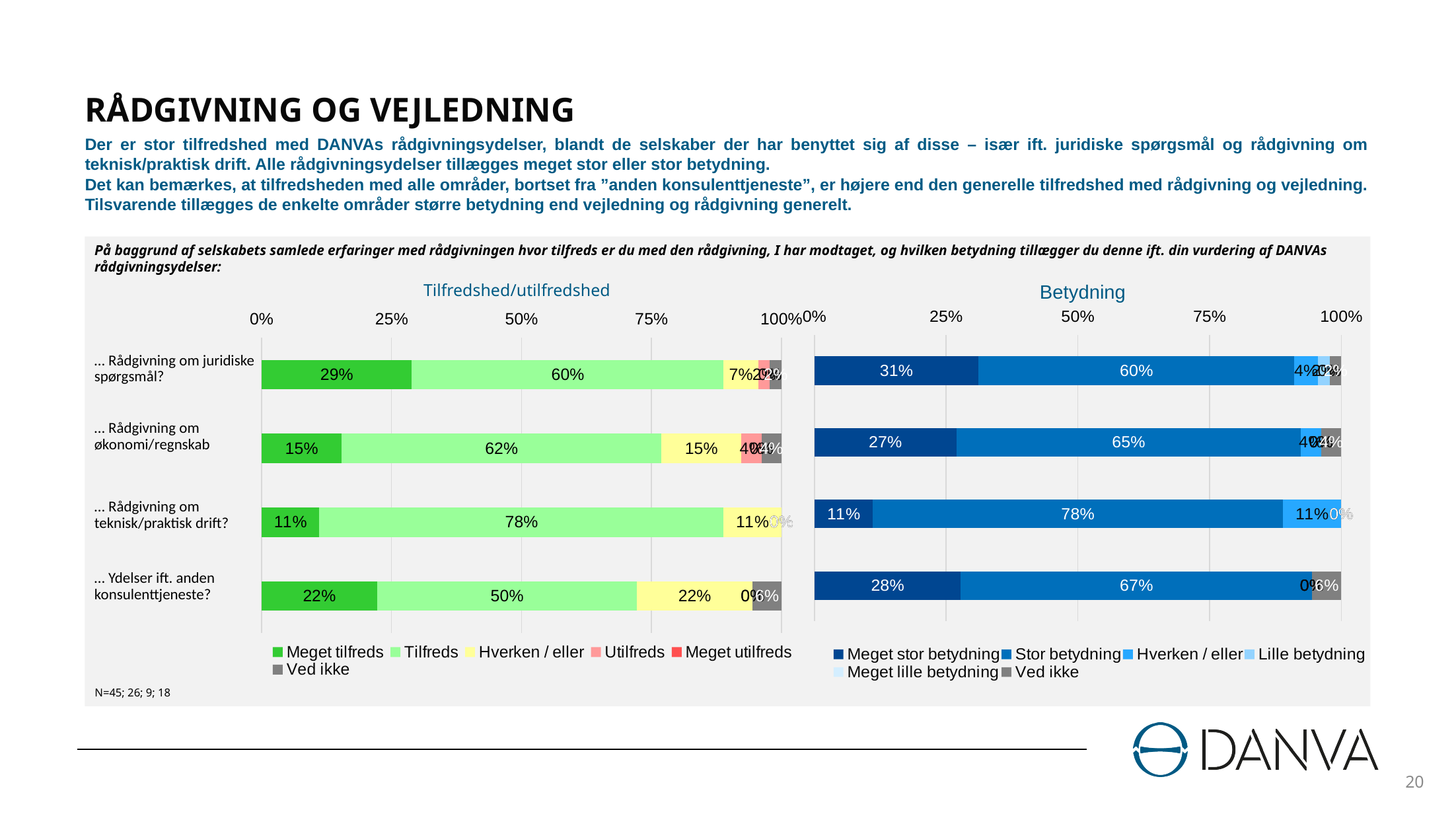
In the Betydning chart, which category has the lowest Meget stor betydning value? Rådgivning om teknisk/praktisk drift? In the Tilfredshed/utilfredshed chart, which category has the highest Meget tilfreds value? Rådgivning om juridiske spørgsmål? In the Tilfredshed/utilfredshed chart, what is the Tilfreds value for "Rådgivning om teknisk/praktisk drift?" 78% What kind of chart is the Betydning chart? Stacked bar chart In the Tilfredshed/utilfredshed chart, what colour represents the Hverken / eller series? Yellow In the Betydning chart, which is larger: the Meget stor betydning value for "Rådgivning om juridiske spørgsmål?" or for "Rådgivning om økonomi/regnskab"? Rådgivning om juridiske spørgsmål? In the Betydning chart, what is the Stor betydning value for "Rådgivning om økonomi/regnskab"? 65% In the Tilfredshed/utilfredshed chart, what is the difference between the Tilfreds values for "Rådgivning om teknisk/praktisk drift?" and "Ydelser ift. anden konsulenttjeneste?" 28% How many series does the legend of the Betydning chart list? 6 In the Betydning chart, what is the Meget stor betydning value for "Ydelser ift. anden konsulenttjeneste?" 28% In the Tilfredshed/utilfredshed chart, what is the Meget tilfreds value for "Rådgivning om juridiske spørgsmål?" 29% How many categories are shown in the Tilfredshed/utilfredshed chart? 4